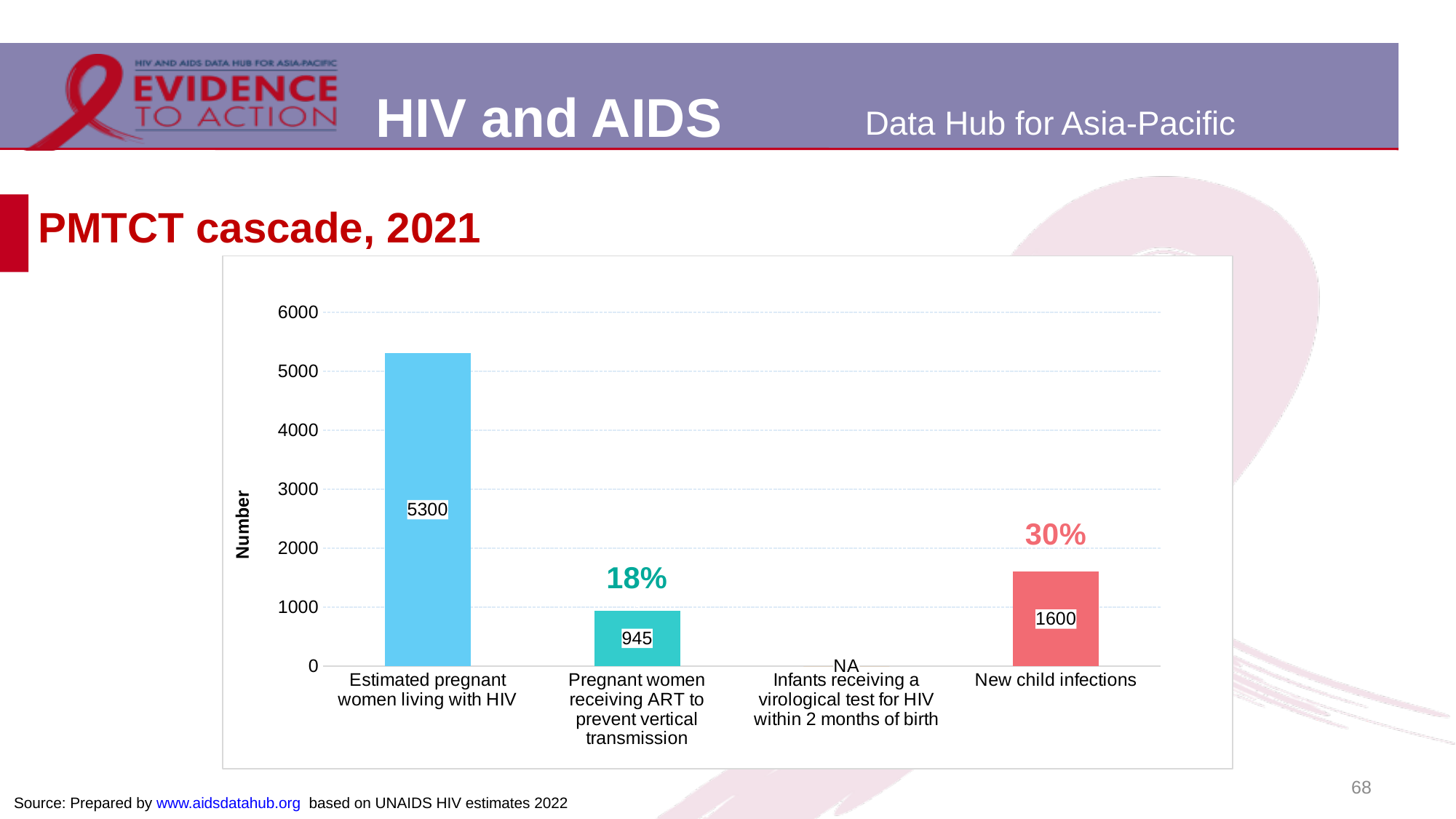
What is the value for Pregnant women receiving ART to prevent vertical transmission? 945 What is the difference between Estimated pregnant women living with HIV and New child infections? 3700 What is shown for Infants receiving a virological test for HIV within 2 months of birth? NA What is the value for Estimated pregnant women living with HIV? 5300 What is the title of the chart? PMTCT cascade, 2021 What kind of chart is this? Bar chart Which is larger: New child infections or Pregnant women receiving ART to prevent vertical transmission? New child infections Which category has the highest value? Estimated pregnant women living with HIV What percentage label is shown above the New child infections bar? 30% What is the value for New child infections? 1600 Which category with a plotted bar has the lowest value? Pregnant women receiving ART to prevent vertical transmission How many categories are shown on the x axis? 4